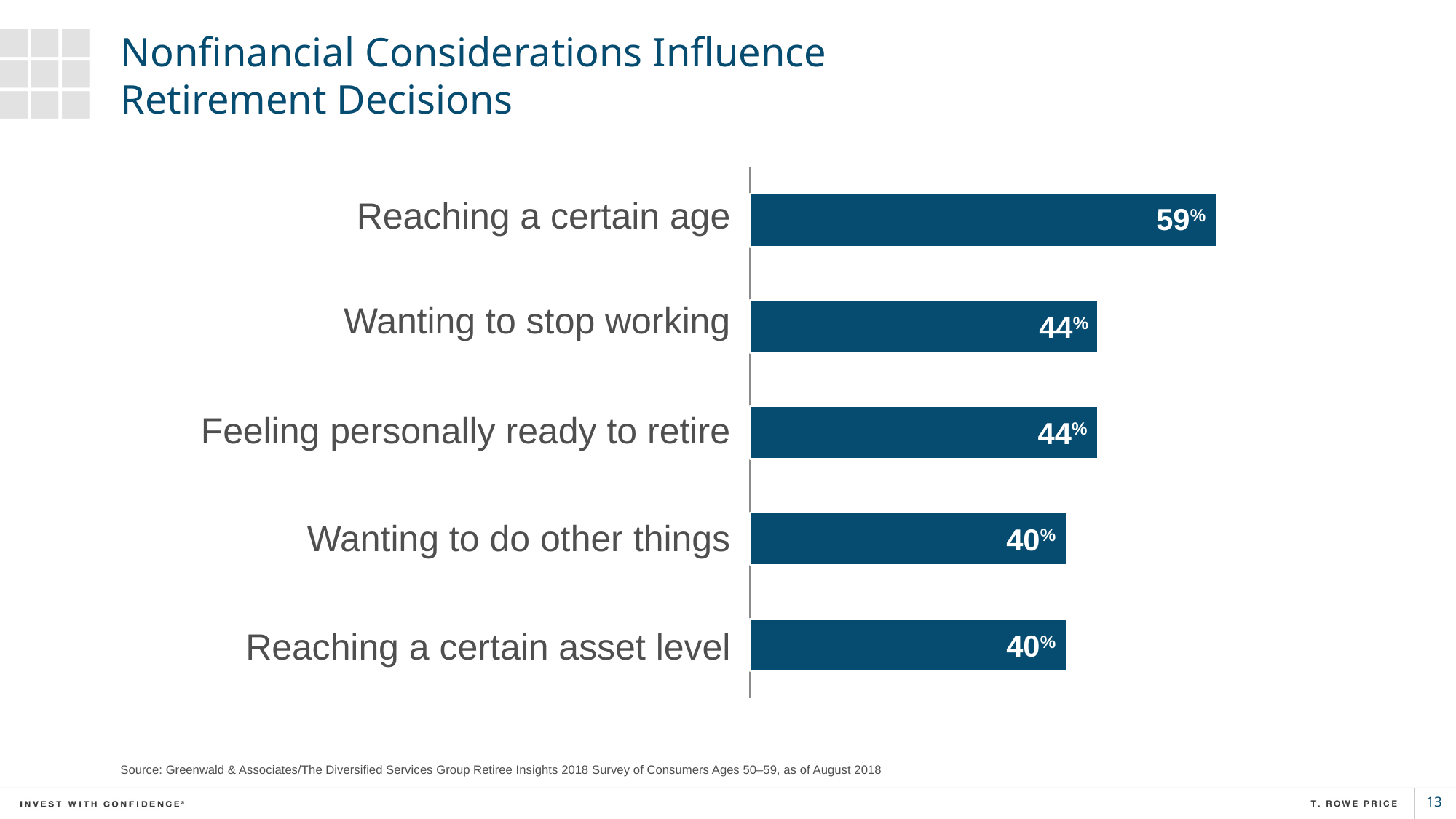
What is the value for "Reaching a certain asset level"? 40% What percentage is shown for "Reaching a certain age"? 59% What percentage is shown for "Wanting to do other things"? 40% What kind of chart is shown on the slide? Bar chart Do the values rise or fall going from the top bar to the bottom bar? Fall What is the difference between the values for "Feeling personally ready to retire" and "Wanting to do other things"? 4% What is the title of the slide containing the chart? Nonfinancial Considerations Influence Retirement Decisions What is the value for "Wanting to stop working"? 44% What is the difference between the values for "Reaching a certain age" and "Wanting to stop working"? 15% Which is larger, the value for "Reaching a certain age" or the value for "Reaching a certain asset level"? Reaching a certain age How many categories are shown in the chart? 5 Which category has the highest value? Reaching a certain age